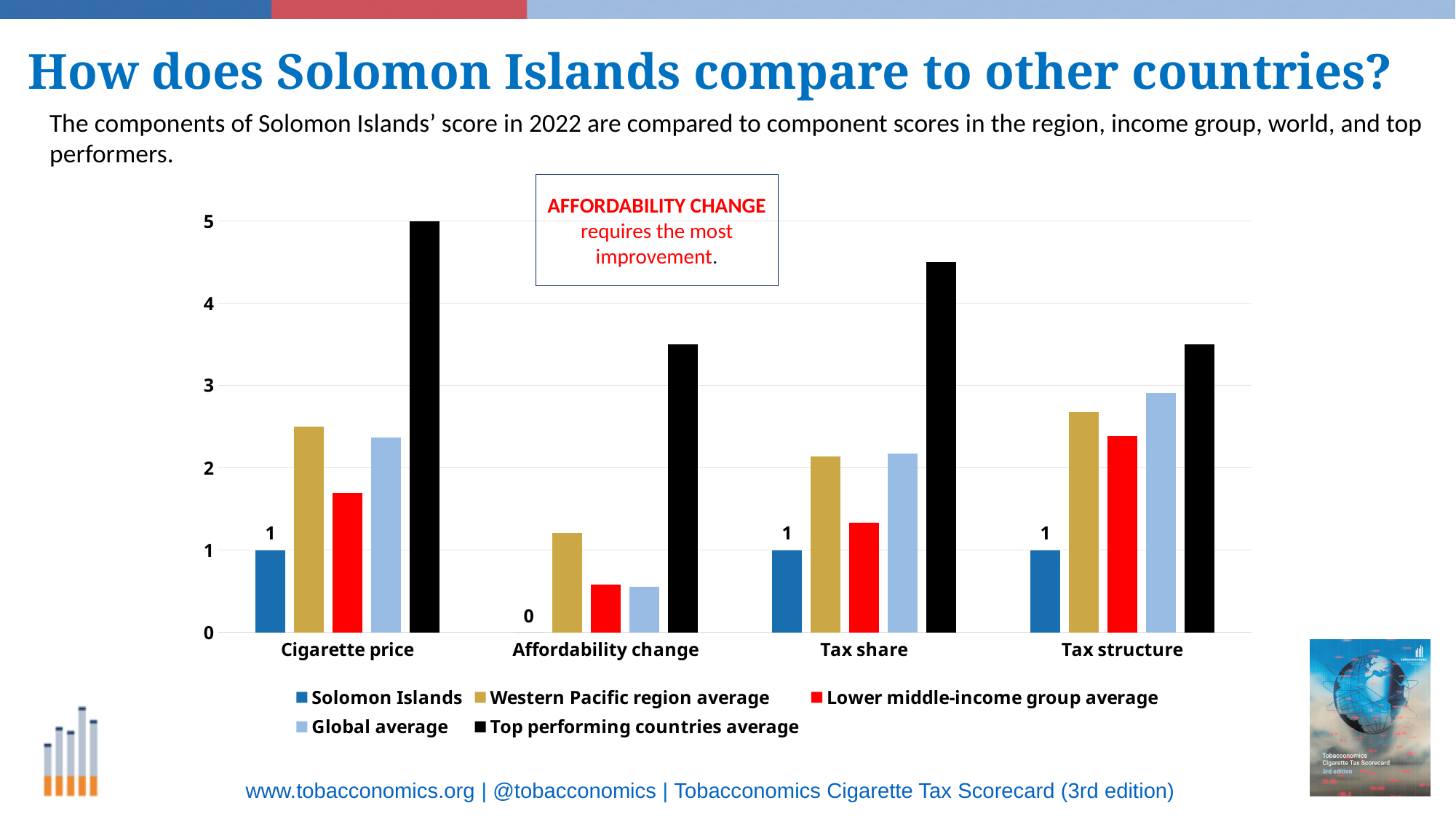
Is the Top performing countries average value for Tax structure greater or less than 3? greater How many categories are shown on the x axis? 4 Is the Global average value for Affordability change greater or less than 1? less How many series does the legend list? 5 What is the Solomon Islands value for Tax share? 1 What is the Solomon Islands value for Affordability change? 0 Is the Western Pacific region average value for Cigarette price greater or less than 2? greater What is the Solomon Islands value for Cigarette price? 1 For which category is the Solomon Islands value lowest? Affordability change For Tax structure, which is larger: the Global average or the Lower middle-income group average? Global average What is the Top performing countries average value for Cigarette price? 5 Which series has the highest value for Tax share? Top performing countries average